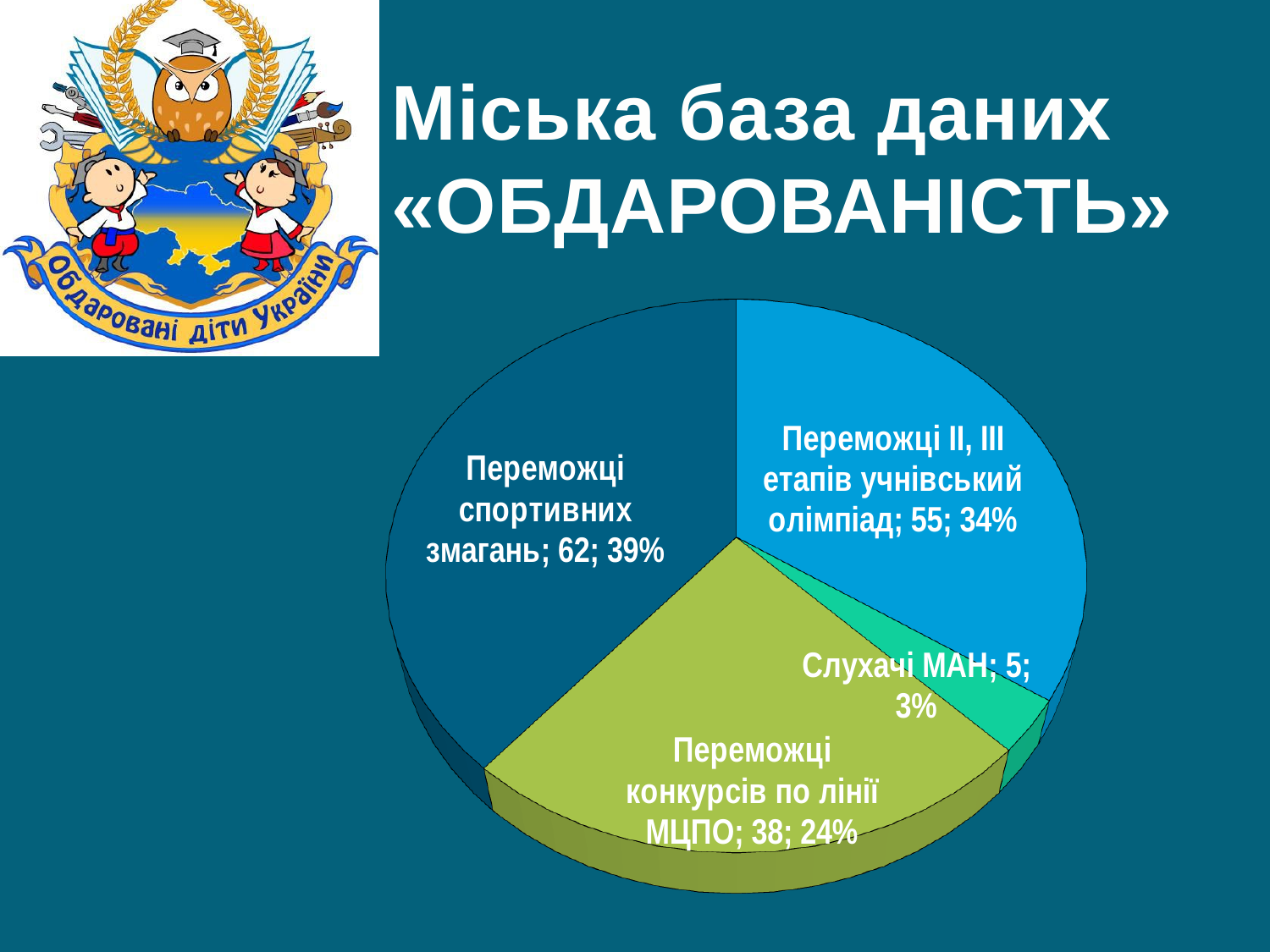
How many slices does the pie chart have? 4 Which is larger: the value for "Переможці ІІ, ІІІ етапів учнівський олімпіад" or for "Переможці конкурсів по лінії МЦПО"? Переможці ІІ, ІІІ етапів учнівський олімпіад What is the value for "Переможці спортивних змагань"? 62 What kind of chart is shown on the slide? pie chart Which category has the largest slice of the pie? Переможці спортивних змагань What share of the pie does "Переможці ІІ, ІІІ етапів учнівський олімпіад" represent? 34% What is the value for "Переможці конкурсів по лінії МЦПО"? 38 Which category has the smallest slice of the pie? Слухачі МАН What share of the pie does "Переможці конкурсів по лінії МЦПО" represent? 24% What is the value for "Переможці ІІ, ІІІ етапів учнівський олімпіад"? 55 What is the value for "Слухачі МАН"? 5 What is the difference between the values for "Переможці спортивних змагань" and "Переможці конкурсів по лінії МЦПО"? 24